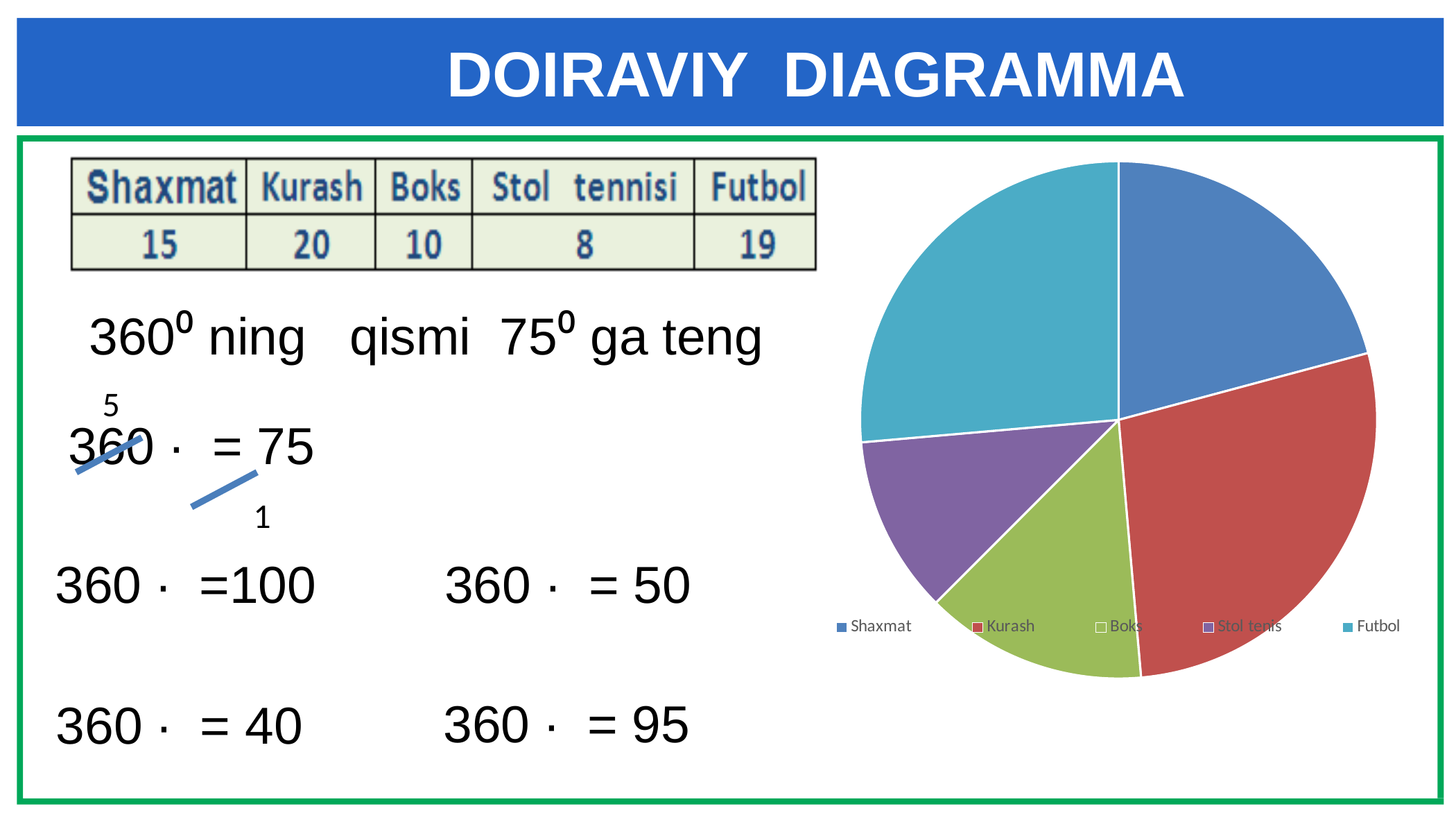
How many slices does the pie chart have? 5 What colour is the Futbol slice in the pie chart? light blue How many entries does the pie chart's legend list? 5 According to the table on the slide, what is the value for Kurash? 20 In the pie chart, which slice is larger, Futbol or Shaxmat? Futbol What colour is the Kurash slice in the pie chart? red Which category has the smallest slice in the pie chart? Stol tenis In the pie chart, which slice is larger, Kurash or Boks? Kurash What kind of chart is shown on the slide? pie chart In the pie chart, which slice is larger, Shaxmat or Stol tenis? Shaxmat According to the table on the slide, what is the value for Stol tennisi? 8 Which category has the largest slice in the pie chart? Kurash